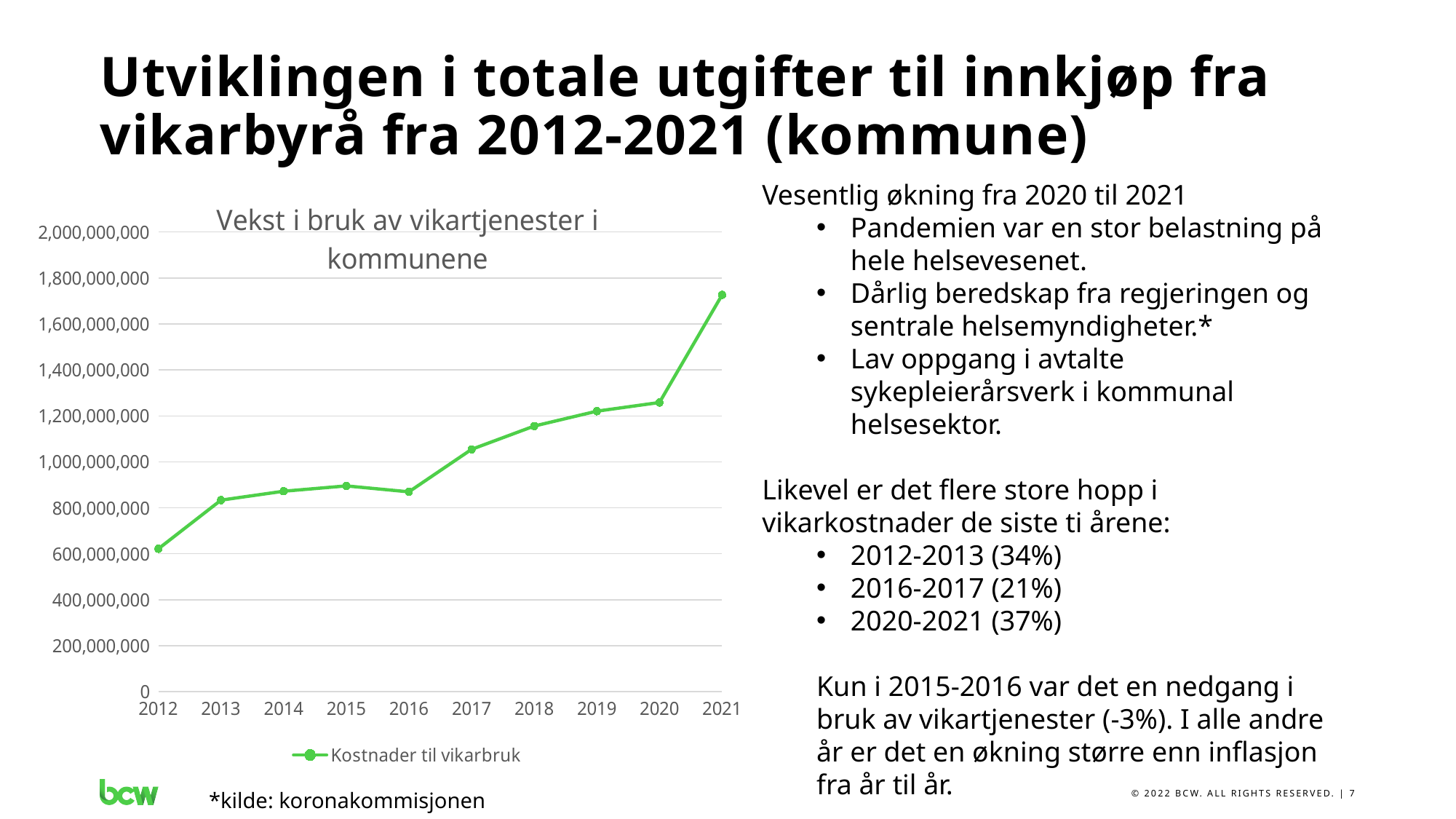
Is the value for 2021 greater or less than 1,600,000,000? greater Which is larger, the value for 2017 or the value for 2016? 2017 How many series does the chart legend list? 1 Which year has the highest value in the chart? 2021 What kind of chart is shown on the slide? Line chart How many years are plotted on the x axis of the chart? 10 Is the value for 2012 greater or less than 800,000,000? less What is the title of the chart? Vekst i bruk av vikartjenester i kommunene Which year has the lowest value in the chart? 2012 What series name is listed in the chart legend? Kostnader til vikarbruk Do the values generally rise or fall from 2012 to 2021? Rise Is the value for 2016 greater or less than 1,000,000,000? less